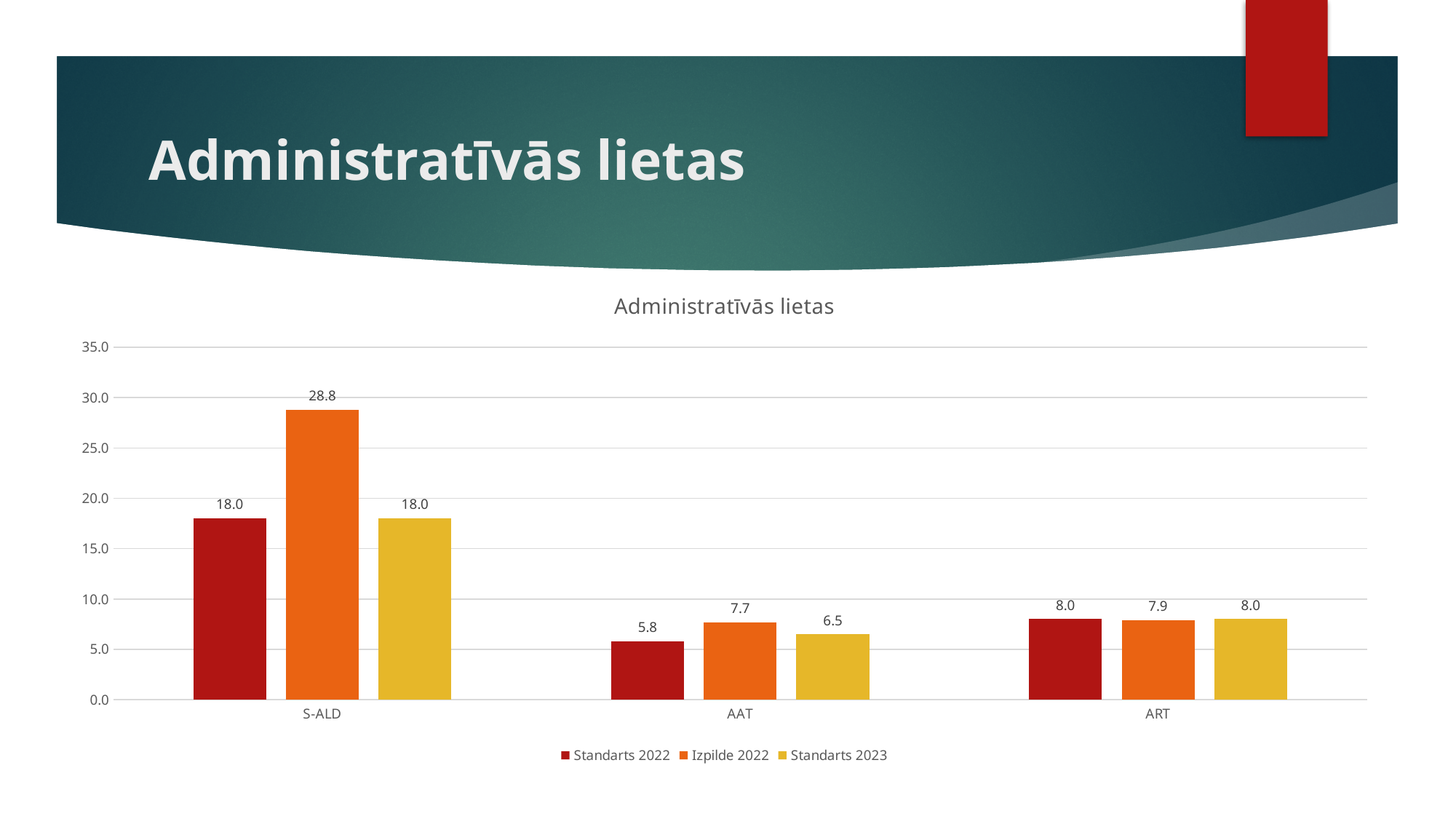
Which category has the highest Izpilde 2022 value? S-ALD Which category has the lowest Standarts 2022 value? AAT Which is larger for AAT: the Izpilde 2022 value or the Standarts 2022 value? Izpilde 2022 What kind of chart is shown on the slide? Bar chart What is the Izpilde 2022 value for ART? 7.9 What is the Standarts 2023 value for AAT? 6.5 What is the Standarts 2022 value for AAT? 5.8 What is the difference between the Izpilde 2022 and Standarts 2022 values for S-ALD? 10.8 How many series does the legend list? 3 What is the difference between the Izpilde 2022 and Standarts 2023 values for AAT? 1.2 How many categories are shown on the x axis? 3 What is the Izpilde 2022 value for S-ALD? 28.8